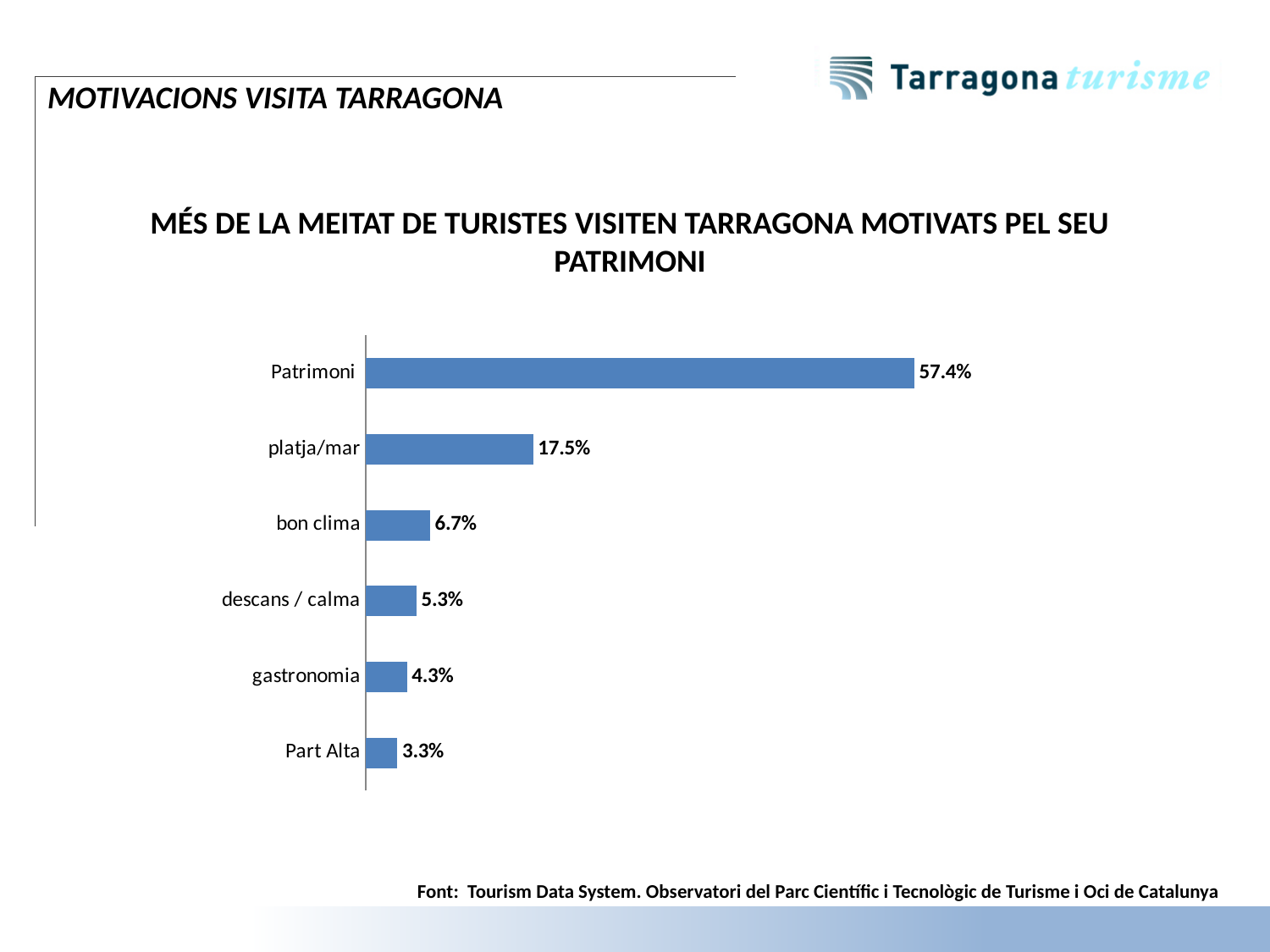
How many categories are shown in the chart? 6 What is the value for Part Alta? 3.3% Which category has the highest value? Patrimoni What is the difference between the values for Patrimoni and platja/mar? 39.9% Which is larger, the value for descans / calma or the value for gastronomia? descans / calma What is the value for gastronomia? 4.3% Which category has the lowest value? Part Alta What is the difference between the values for bon clima and descans / calma? 1.4% What is the value for platja/mar? 17.5% What is the value for Patrimoni? 57.4% What kind of chart is shown on the slide? Bar chart What is the title of the chart? MÉS DE LA MEITAT DE TURISTES VISITEN TARRAGONA MOTIVATS PEL SEU PATRIMONI